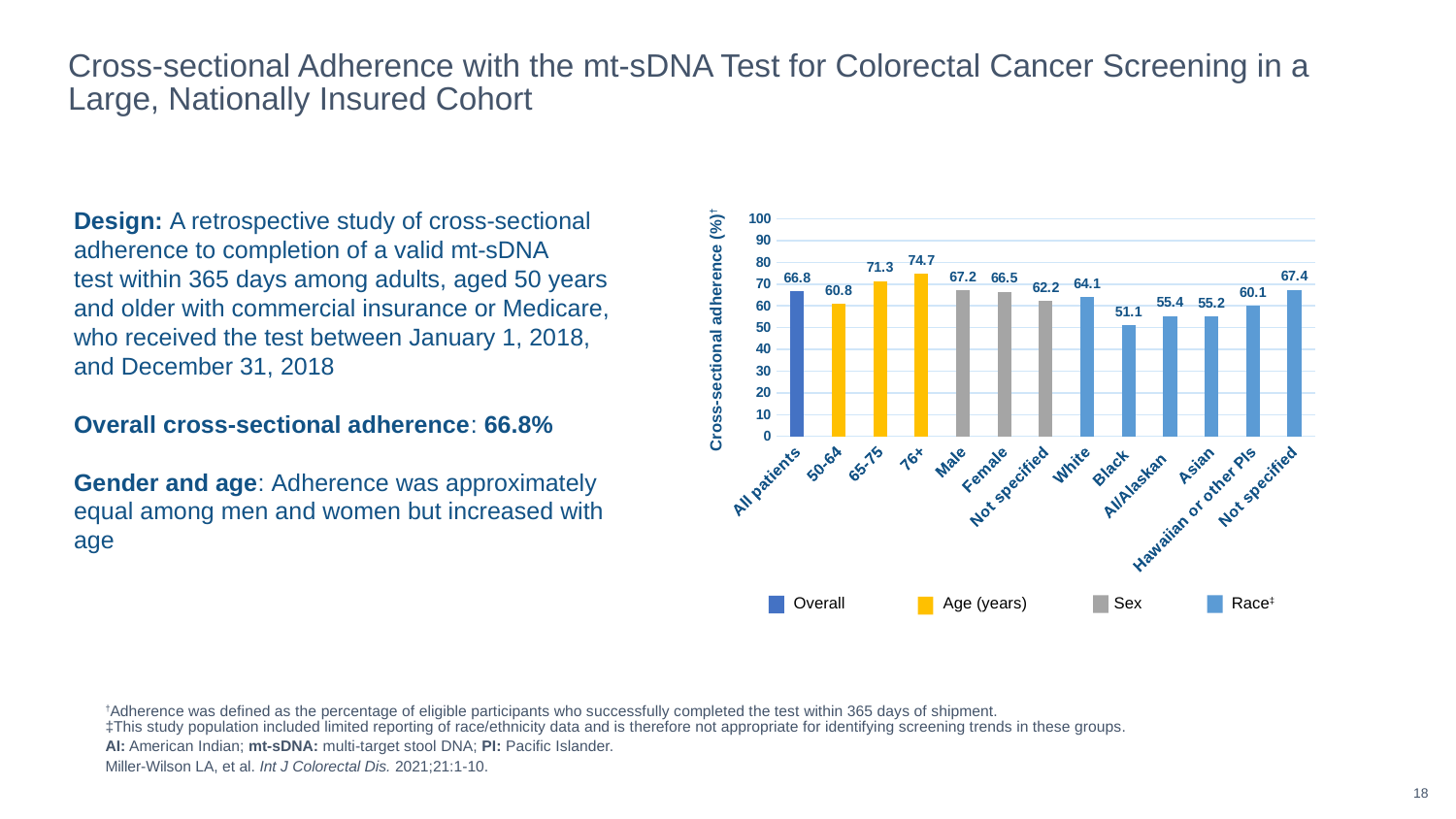
What is the cross-sectional adherence value for Black patients? 51.1 What kind of chart is shown on the slide? Bar chart Across the age groups 50-64, 65-75 and 76+, does cross-sectional adherence rise or fall with increasing age? Rise What is the cross-sectional adherence value for the 76+ age group? 74.7 Which category has the lowest cross-sectional adherence? Black Which has the higher cross-sectional adherence, Male or Female? Male Is the cross-sectional adherence for White patients greater or less than 60? greater How many series does the legend list? 4 What is the cross-sectional adherence value for the Hawaiian or other PIs group? 60.1 What is the difference in cross-sectional adherence between the 76+ and 50-64 age groups? 13.9 Which category has the highest cross-sectional adherence? 76+ How many bars are plotted in the chart? 13